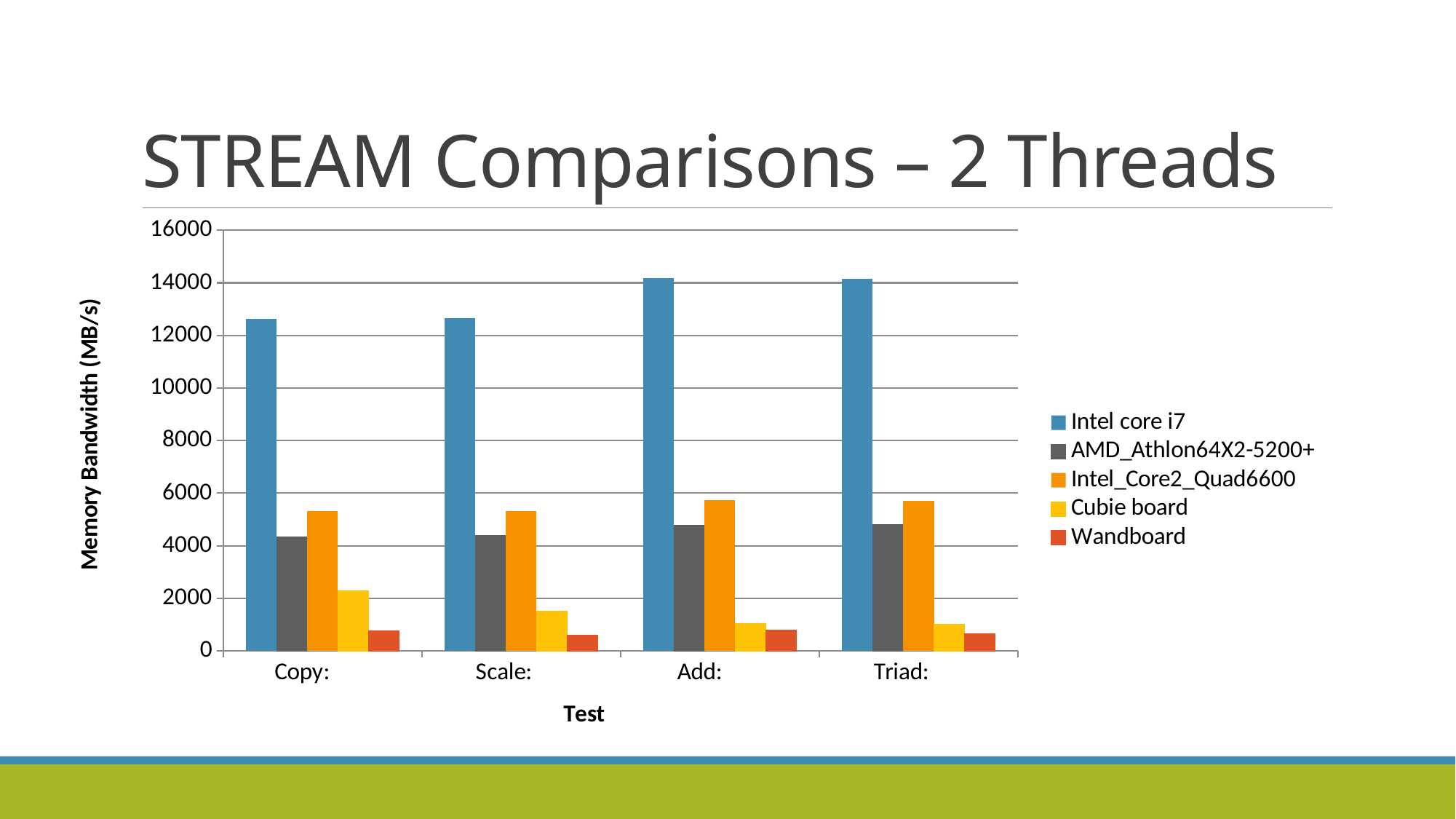
Which series has the highest memory bandwidth for the Copy test? Intel core i7 What is the title of the y axis? Memory Bandwidth (MB/s) How many test categories are shown on the x axis? 4 Is the value for Intel core i7 on the Copy test greater or less than 12000? greater Do the Cubie board values rise or fall from Copy to Triad along the x axis? fall Which series has the lowest memory bandwidth for the Copy test? Wandboard For the Add test, which is larger: Intel_Core2_Quad6600 or AMD_Athlon64X2-5200+? Intel_Core2_Quad6600 What kind of chart is shown on the slide? bar chart How many series does the legend list? 5 Is the value for AMD_Athlon64X2-5200+ on the Copy test greater or less than 4000? greater Is the value for Cubie board on the Copy test greater or less than 2000? greater